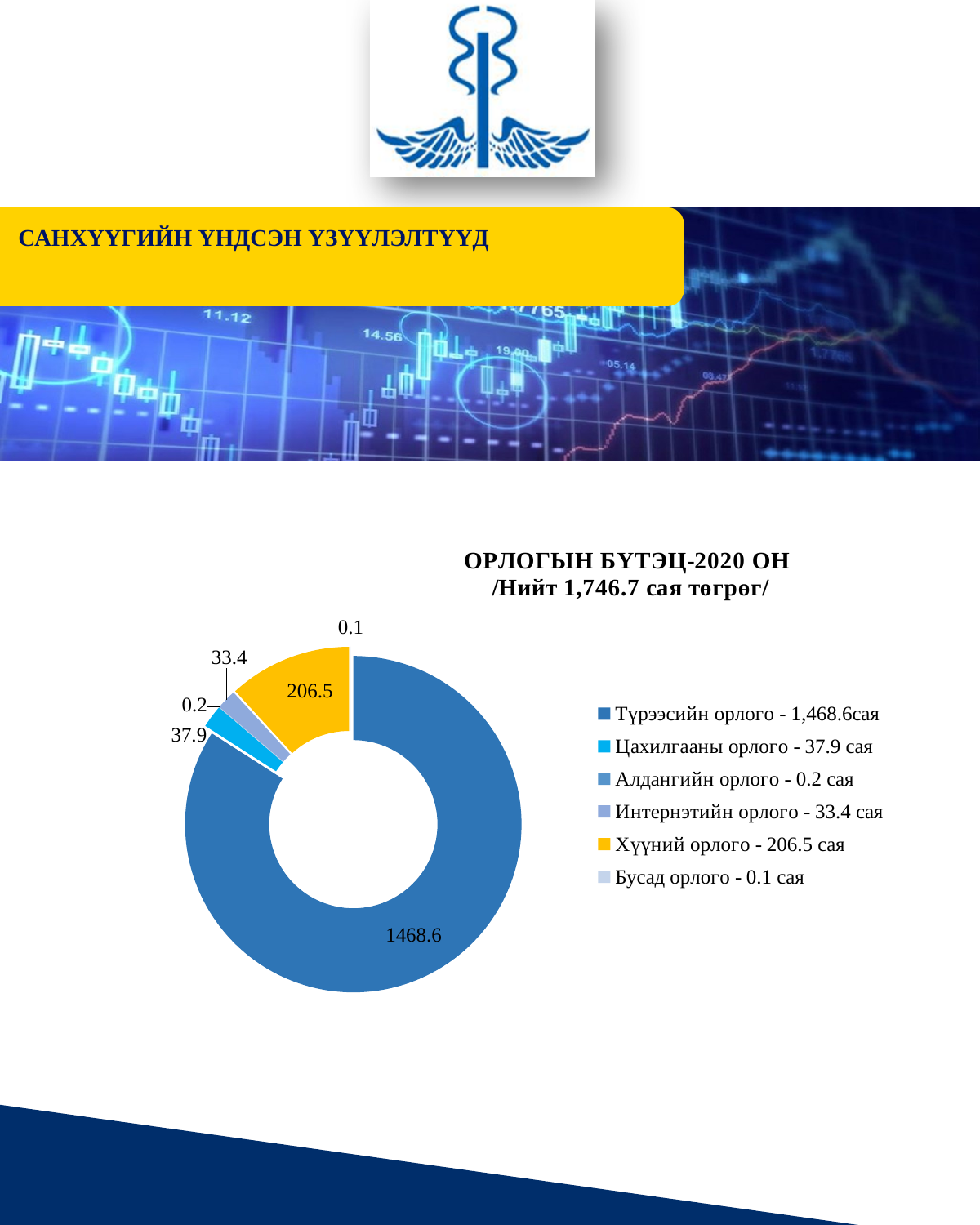
Which is larger, Цахилгааны орлого or Интернэтийн орлого? Цахилгааны орлого What type of chart is shown on the slide? Doughnut chart What colour is the slice for Хүүний орлого? Yellow Which income category has the largest value? Түрээсийн орлого Which income category has the smallest value? Бусад орлого What is the difference between Хүүний орлого and Цахилгааны орлого? 168.6 What total amount is stated in the chart title? 1,746.7 сая төгрөг What is the title of the chart? ОРЛОГЫН БҮТЭЦ-2020 ОН /Нийт 1,746.7 сая төгрөг/ What is the value shown for Хүүний орлого? 206.5 What is the value shown for Интернэтийн орлого? 33.4 What is the value shown for Түрээсийн орлого? 1468.6 How many income categories does the chart show? 6